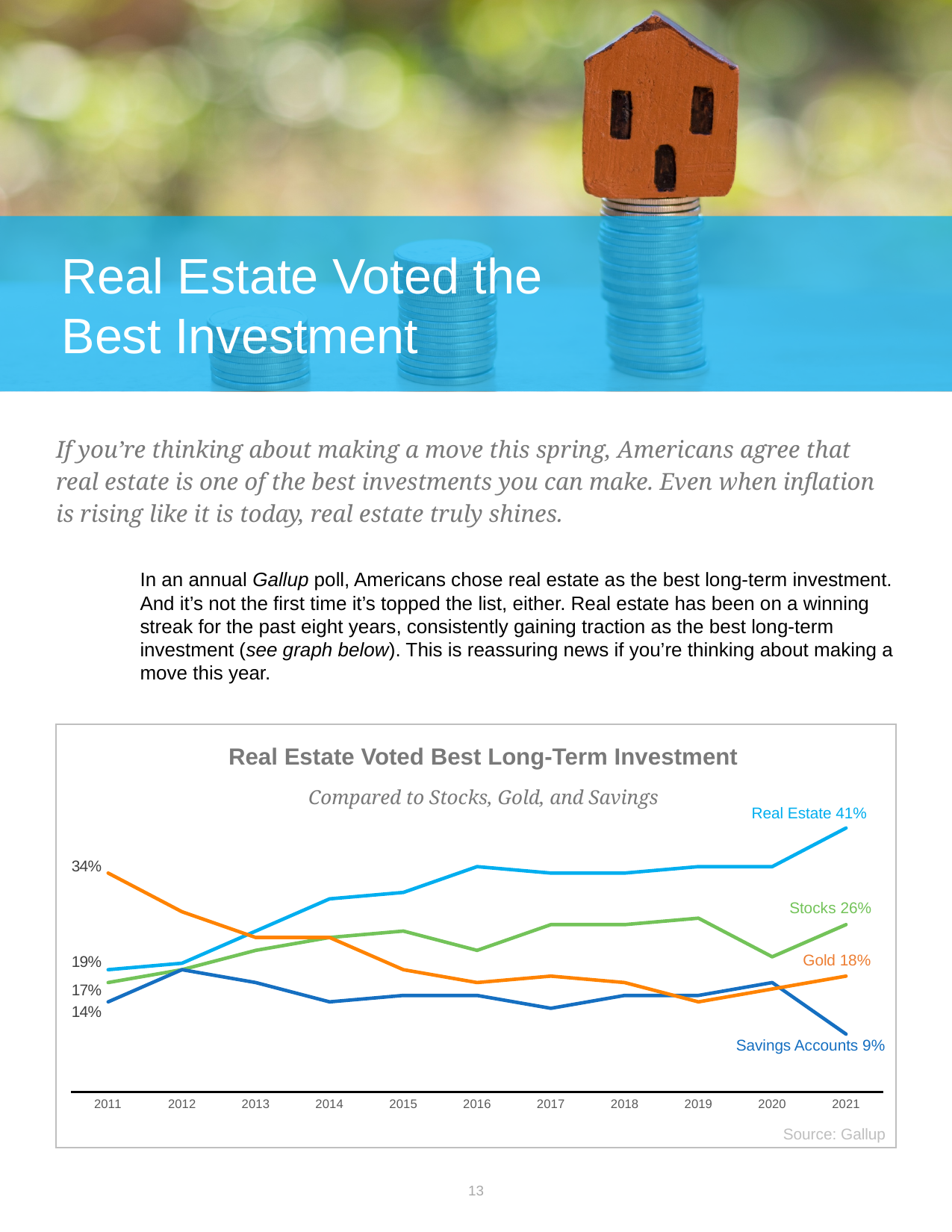
What value is shown for Gold in 2011? 34% What kind of chart is this? Line chart Which investment has the highest value in 2021? Real Estate Which investment has the lowest value in 2021? Savings Accounts What value is shown for Stocks in 2021? 26% What value is shown for Gold in 2021? 18% In 2021, which is larger: Gold or Stocks? Stocks What is the difference between the Real Estate and Stocks values in 2021? 15 percentage points How many series are plotted on the chart? 4 What value is shown for Real Estate in 2021? 41% How many years are shown on the x axis? 11 What value is shown for Savings Accounts in 2021? 9%